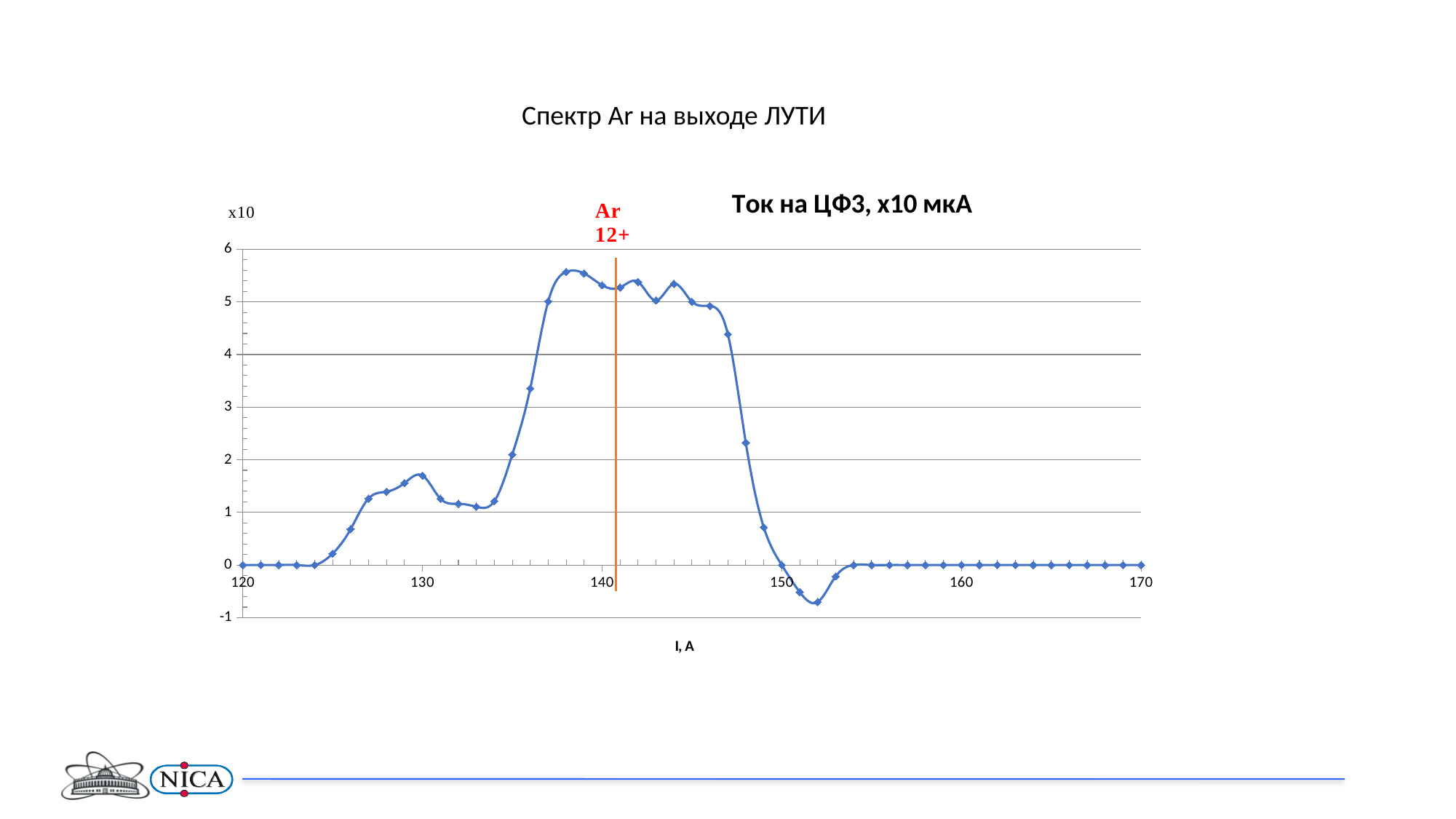
What is the plotted value at I = 160 A? 0 What is the label of the x axis? I, A Do the values rise or fall as I goes from 147 A to 152 A? fall Which is larger, the value at I = 138 A or the value at I = 130 A? I = 138 A Is the value at I = 136 A greater or less than 3? greater Is the value at I = 149 A greater or less than 1? less Is the value at I = 138 A greater or less than 5? greater At which value of I does the curve reach its lowest point? 152 What kind of chart is shown on the slide? line chart What is the title of the chart? Ток на ЦФ3, x10 мкА What is the plotted value at I = 120 A? 0